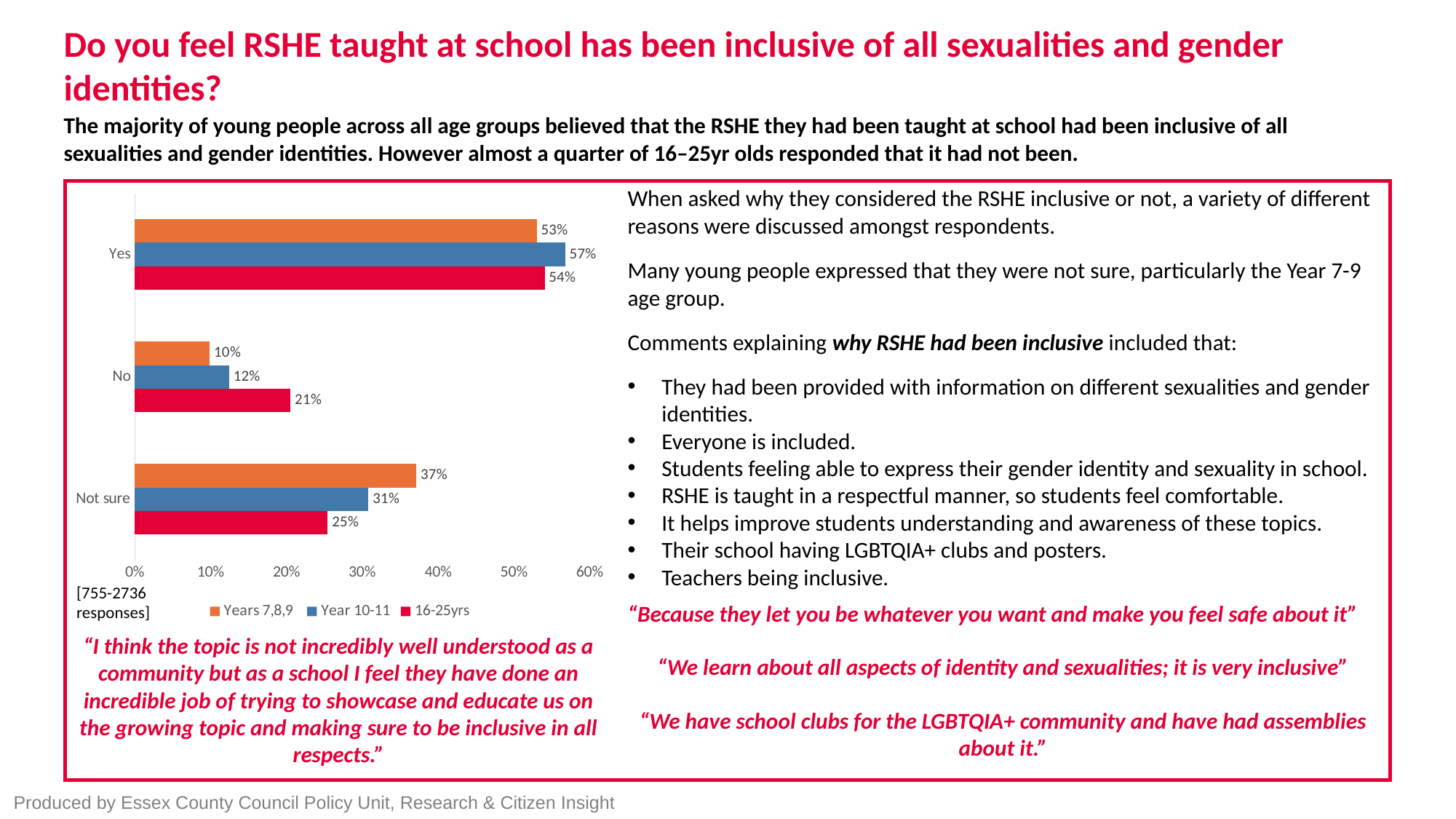
What percentage of Year 10-11 respondents answered Yes? 57% What percentage of Years 7,8,9 respondents answered Not sure? 37% What is the difference between the 16-25yrs and Years 7,8,9 percentages for No? 11% For Not sure, which is larger: Years 7,8,9 or Year 10-11? Years 7,8,9 Which age group has the lowest percentage answering Not sure? 16-25yrs What percentage of 16-25yrs respondents answered No? 21% What kind of chart is shown on the slide? Bar chart Is the value for 16-25yrs answering Yes greater or less than 50%? greater How many response categories are shown on the chart? 3 Which colour represents the 16-25yrs series in the chart? Red How many series does the legend list? 3 Which age group has the highest percentage answering Yes? Year 10-11